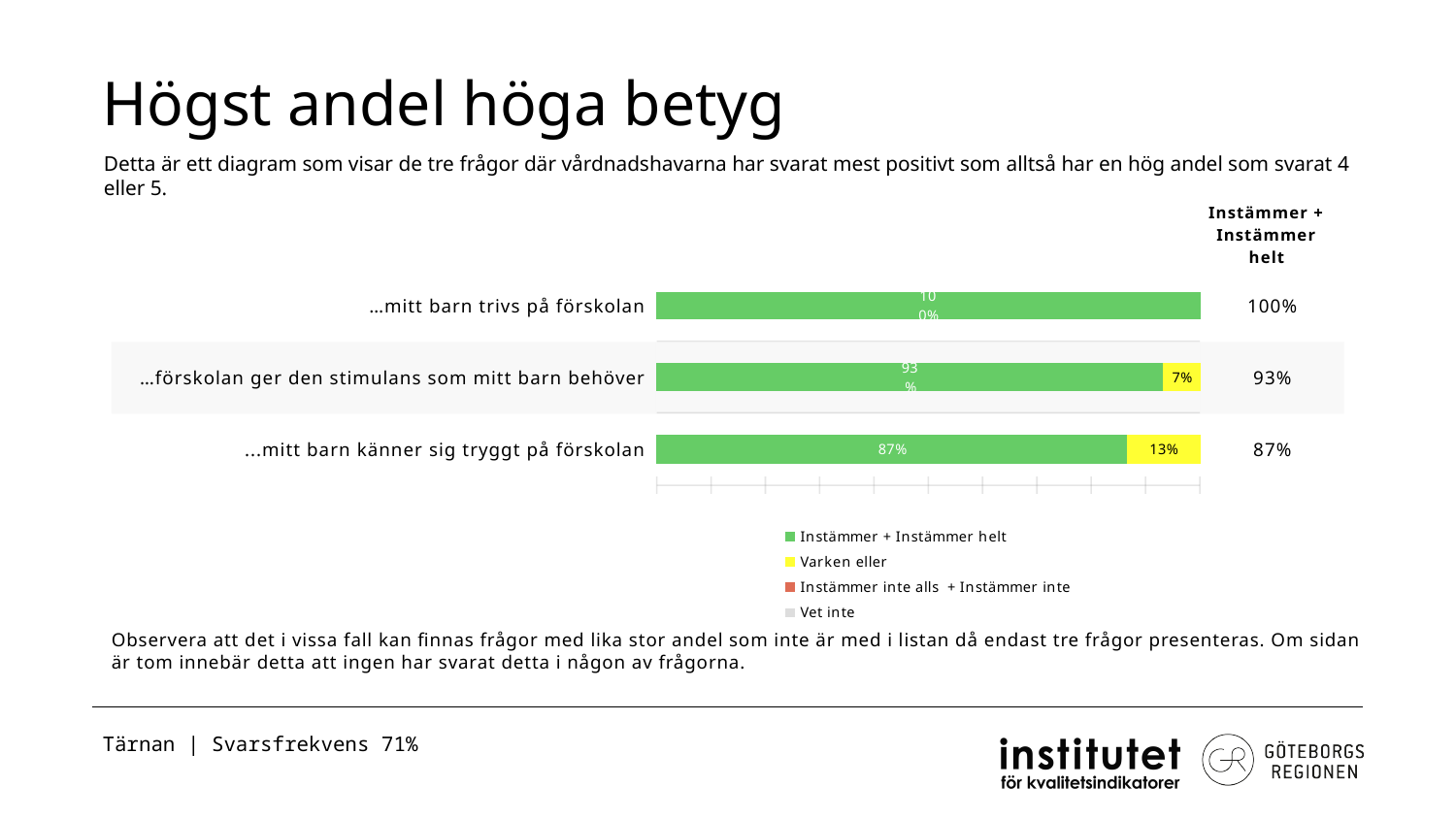
Which has a larger 'Varken eller' share: '…förskolan ger den stimulans som mitt barn behöver' or '…mitt barn känner sig tryggt på förskolan'? …mitt barn känner sig tryggt på förskolan What is the 'Varken eller' value for '…mitt barn känner sig tryggt på förskolan'? 13% Which question has the highest share of 'Instämmer + Instämmer helt'? …mitt barn trivs på förskolan What colour represents 'Varken eller' in the chart? Yellow What is the 'Instämmer + Instämmer helt' value shown in the right-hand column for '…mitt barn trivs på förskolan'? 100% What is the difference in 'Instämmer + Instämmer helt' between '…förskolan ger den stimulans som mitt barn behöver' and '…mitt barn känner sig tryggt på förskolan'? 6% Which question has the lowest share of 'Instämmer + Instämmer helt'? …mitt barn känner sig tryggt på förskolan What is the 'Instämmer + Instämmer helt' value for '…mitt barn känner sig tryggt på förskolan'? 87% How many series does the legend list? 4 What is the 'Varken eller' value for '…förskolan ger den stimulans som mitt barn behöver'? 7% How many questions (categories) are shown in the chart? 3 What kind of chart is shown on the slide? Stacked bar chart